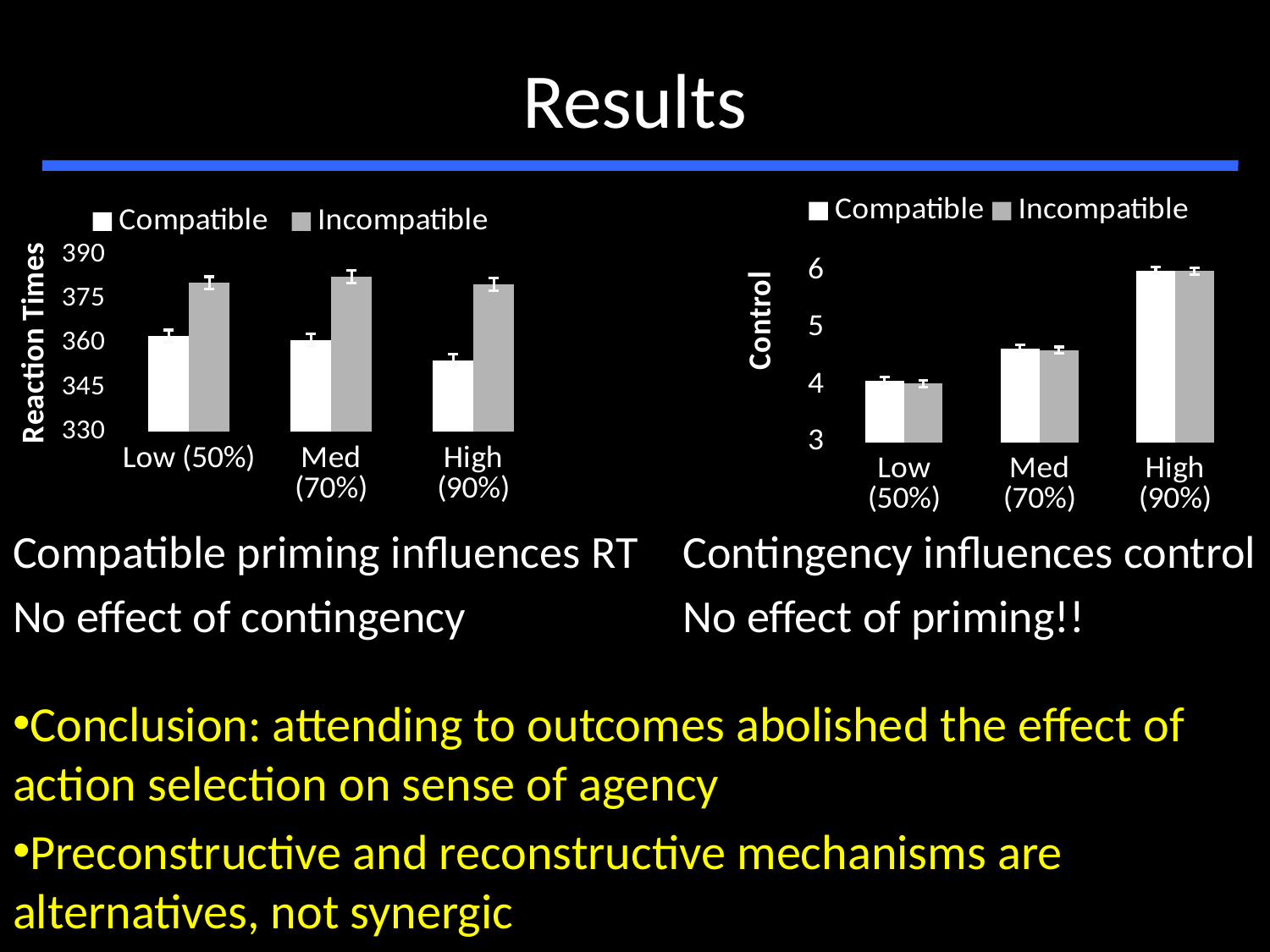
What kind of chart is the left chart with the Reaction Times axis? bar chart In the left chart (Reaction Times), is the Compatible value for Low (50%) greater or less than 345? greater In the right chart (Control), which category has the highest Compatible value? High (90%) In the right chart (Control), do the Compatible values rise or fall from Low (50%) to High (90%)? rise In the right chart (Control), is the Incompatible value for Low (50%) greater or less than 5? less In the right chart (Control), is the Compatible value for High (90%) greater or less than 5? greater In the left chart (Reaction Times), how many series does the legend list? 2 What is the y-axis title of the left chart? Reaction Times In the right chart (Control), how many categories are shown on the x axis? 3 In the left chart (Reaction Times), which is larger for Low (50%): Compatible or Incompatible? Incompatible